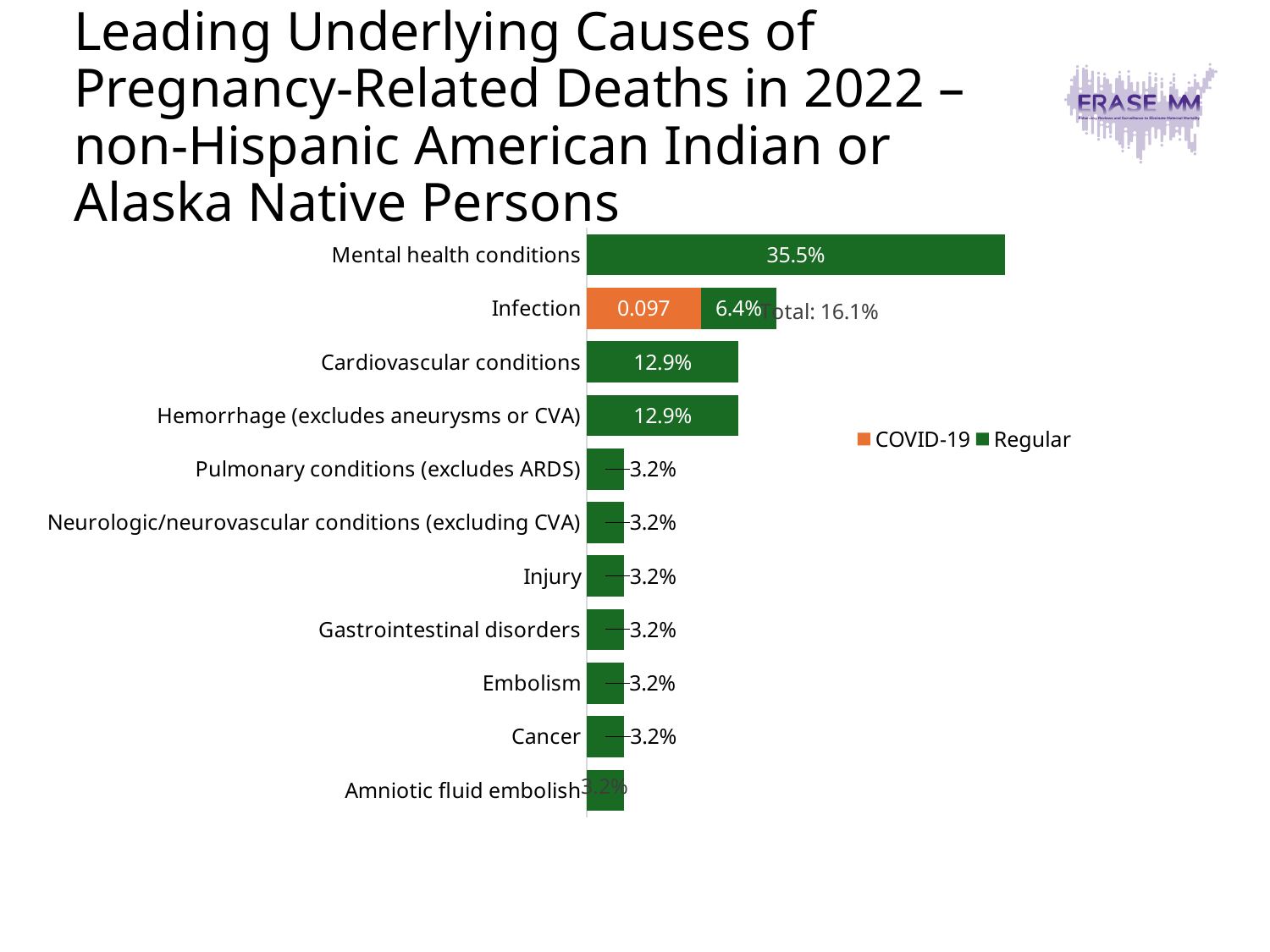
What is the value for Cardiovascular conditions? 12.9% What is the value for Cancer? 3.2% What is the COVID-19 value for Infection? 0.097 What is the difference between Mental health conditions and Cardiovascular conditions? 22.6% What is the value for Mental health conditions? 35.5% Which category has the highest value? Mental health conditions What total is shown for the Infection bar? 16.1% Which is larger, the value for Hemorrhage (excludes aneurysms or CVA) or the value for Embolism? Hemorrhage (excludes aneurysms or CVA) How many series does the legend list? 2 How many categories are shown on the chart? 11 What is the Regular value for Infection? 6.4% What kind of chart is shown? Bar chart